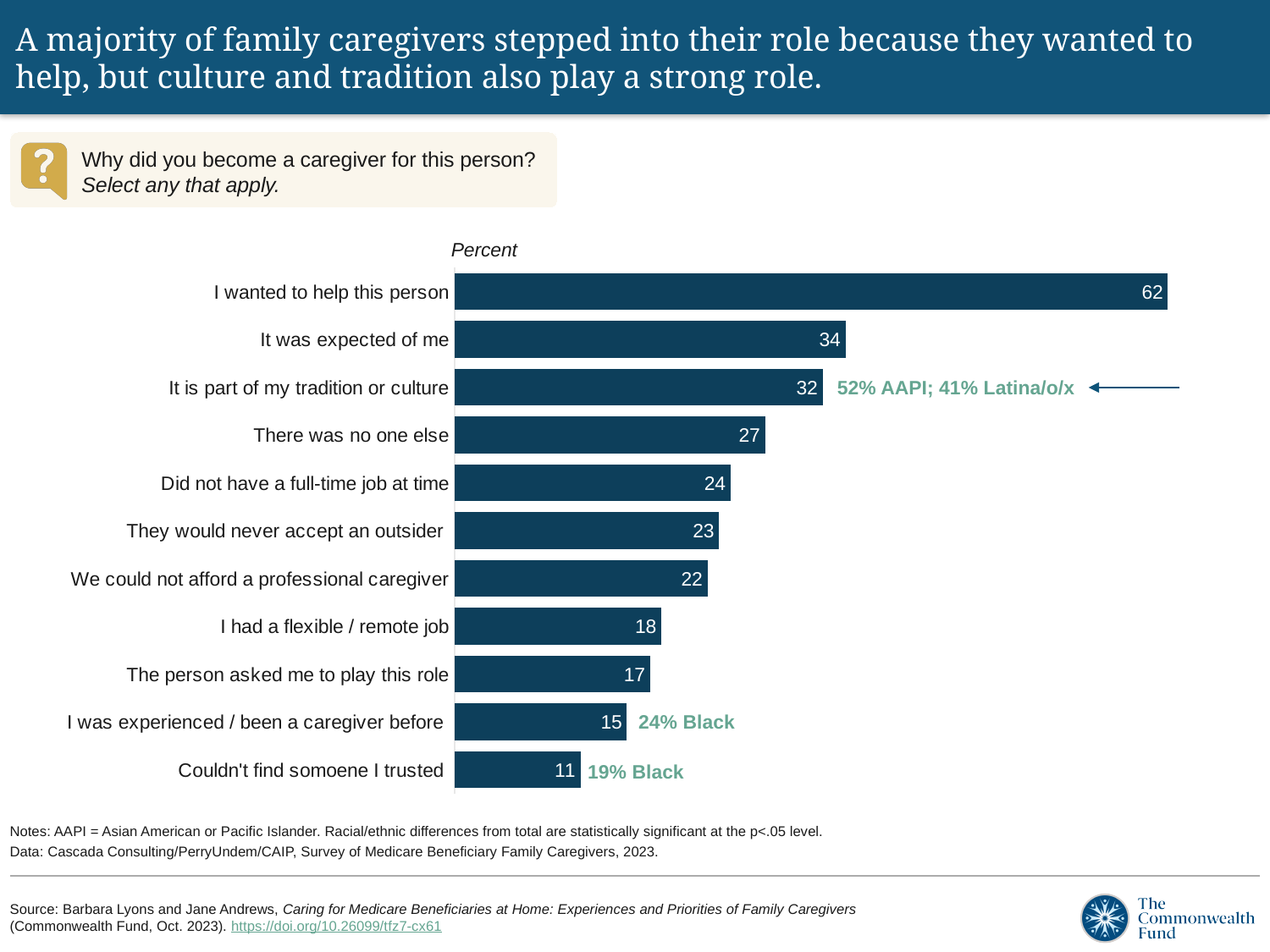
What is the axis label shown above the bars? Percent Which reason has the highest percentage? I wanted to help this person What percentage of Black caregivers said they were experienced / had been a caregiver before, according to the annotation? 24% What is the difference between "It was expected of me" and "There was no one else"? 7 What percentage of AAPI caregivers said it is part of their tradition or culture, according to the annotation? 52% How many reasons (categories) are shown in the chart? 11 What percentage of caregivers said "I wanted to help this person"? 62 What is the value for "It is part of my tradition or culture"? 32 What kind of chart is shown on the slide? Bar chart What is the value for "We could not afford a professional caregiver"? 22 Which reason has the lowest percentage? Couldn't find somoene I trusted Which is larger: "I had a flexible / remote job" or "The person asked me to play this role"? I had a flexible / remote job